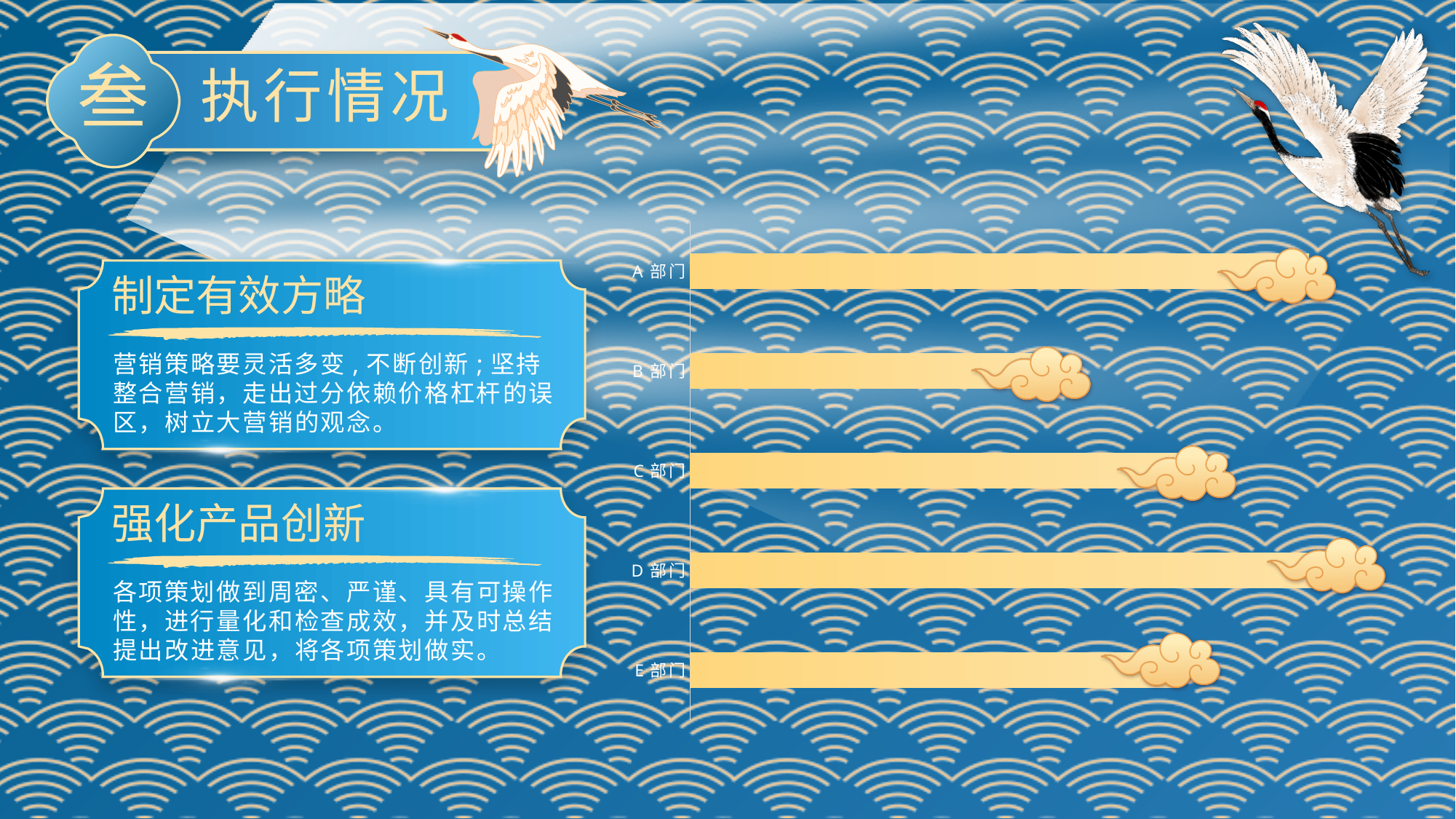
How many departments (categories) are plotted in the bar chart? 5 Which bar is longer, C 部门 or B 部门? C 部门 Which bar is longer, D 部门 or E 部门? D 部门 Which bar is longer, E 部门 or B 部门? E 部门 What colour are the bars in the chart? gold/yellow Which department label appears at the top of the bar chart? A 部门 What kind of chart is shown on the right side of the slide? bar chart Which department has the shortest bar in the chart? B 部门